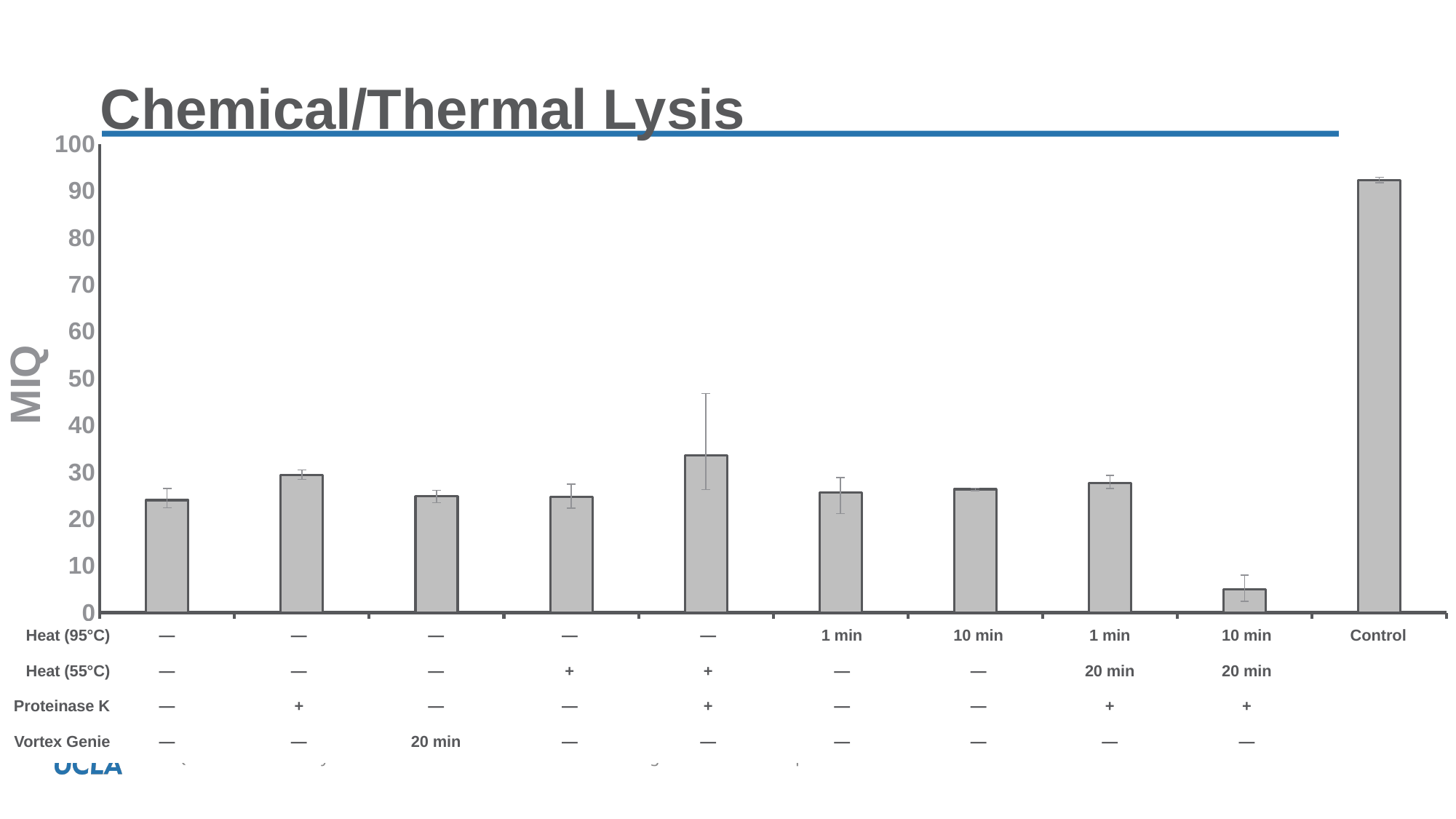
What kind of chart is shown on the slide? bar chart Is the MIQ value for the condition with Vortex Genie 20 min greater or less than 30? less Which has a larger MIQ value: the bar with Proteinase K + only or the bar with Heat (95°C) 10 min, Heat (55°C) 20 min and Proteinase K +? Proteinase K + only Is the MIQ value for the condition with Heat (95°C) 10 min, Heat (55°C) 20 min and Proteinase K + greater or less than 10? less Is the MIQ value for the Control bar greater or less than 90? greater How many bars are plotted in the chart? 10 What is the title of the slide containing the chart? Chemical/Thermal Lysis What is the label on the y axis of the chart? MIQ Which has a larger MIQ value: the Control bar or the bar with Heat (95°C) 1 min only? Control Which condition has the lowest MIQ value? Heat (95°C) 10 min, Heat (55°C) 20 min, Proteinase K + Which condition has the highest MIQ value? Control